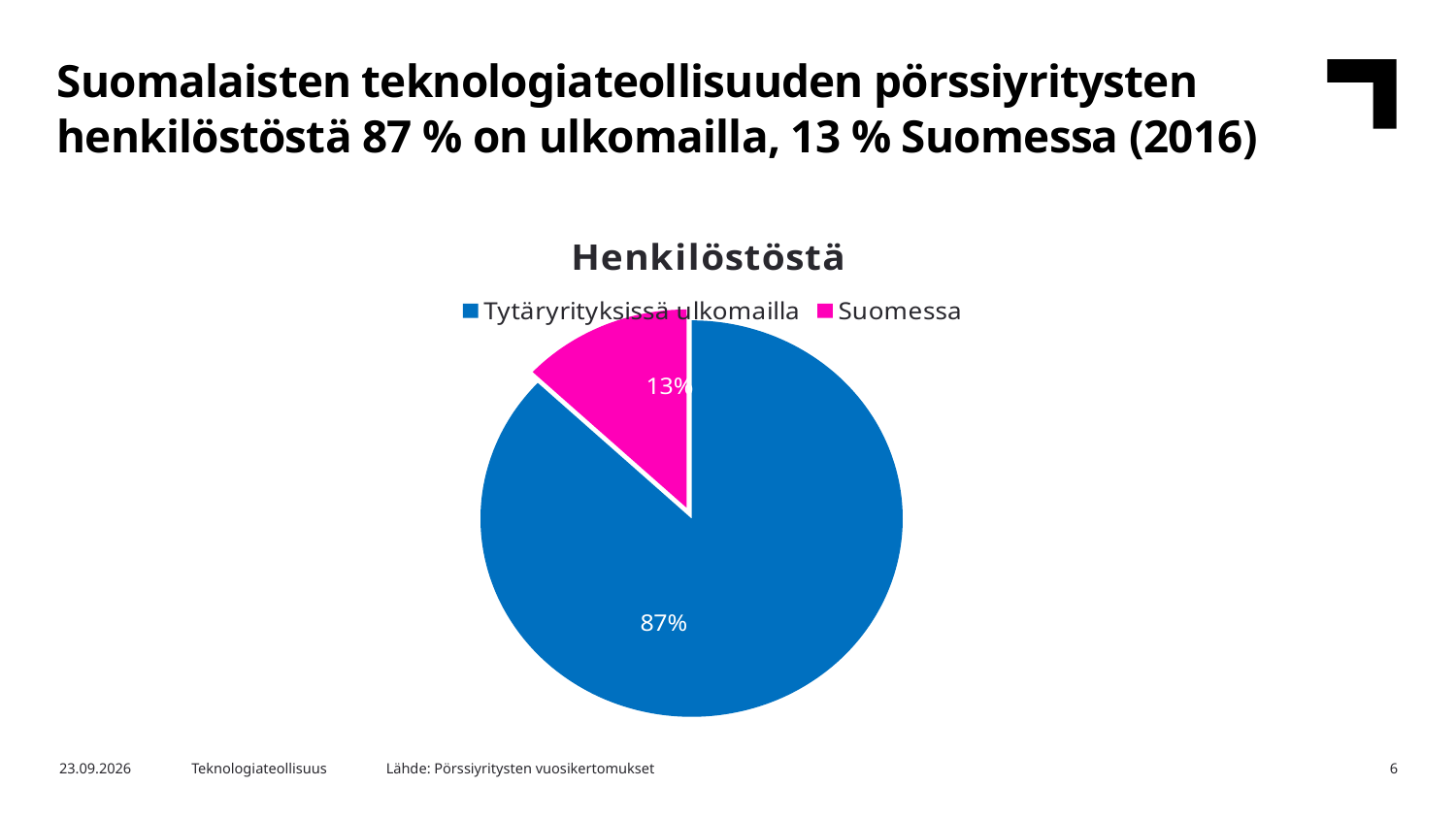
What kind of chart is shown on the slide? Pie chart How many entries does the legend list? 2 Which slice is the smallest in the pie chart? Suomessa What share of the pie does the 'Tytäryrityksissä ulkomailla' slice represent? 87% What share of the pie does the 'Suomessa' slice represent? 13% How many slices does the pie chart have? 2 What colour is the 'Suomessa' slice? Magenta (pink) What is the difference in percentage points between the 'Tytäryrityksissä ulkomailla' and 'Suomessa' slices? 74 percentage points Which is larger, the 'Suomessa' slice or the 'Tytäryrityksissä ulkomailla' slice? Tytäryrityksissä ulkomailla What is the title of the chart? Henkilöstöstä Which slice is the largest in the pie chart? Tytäryrityksissä ulkomailla